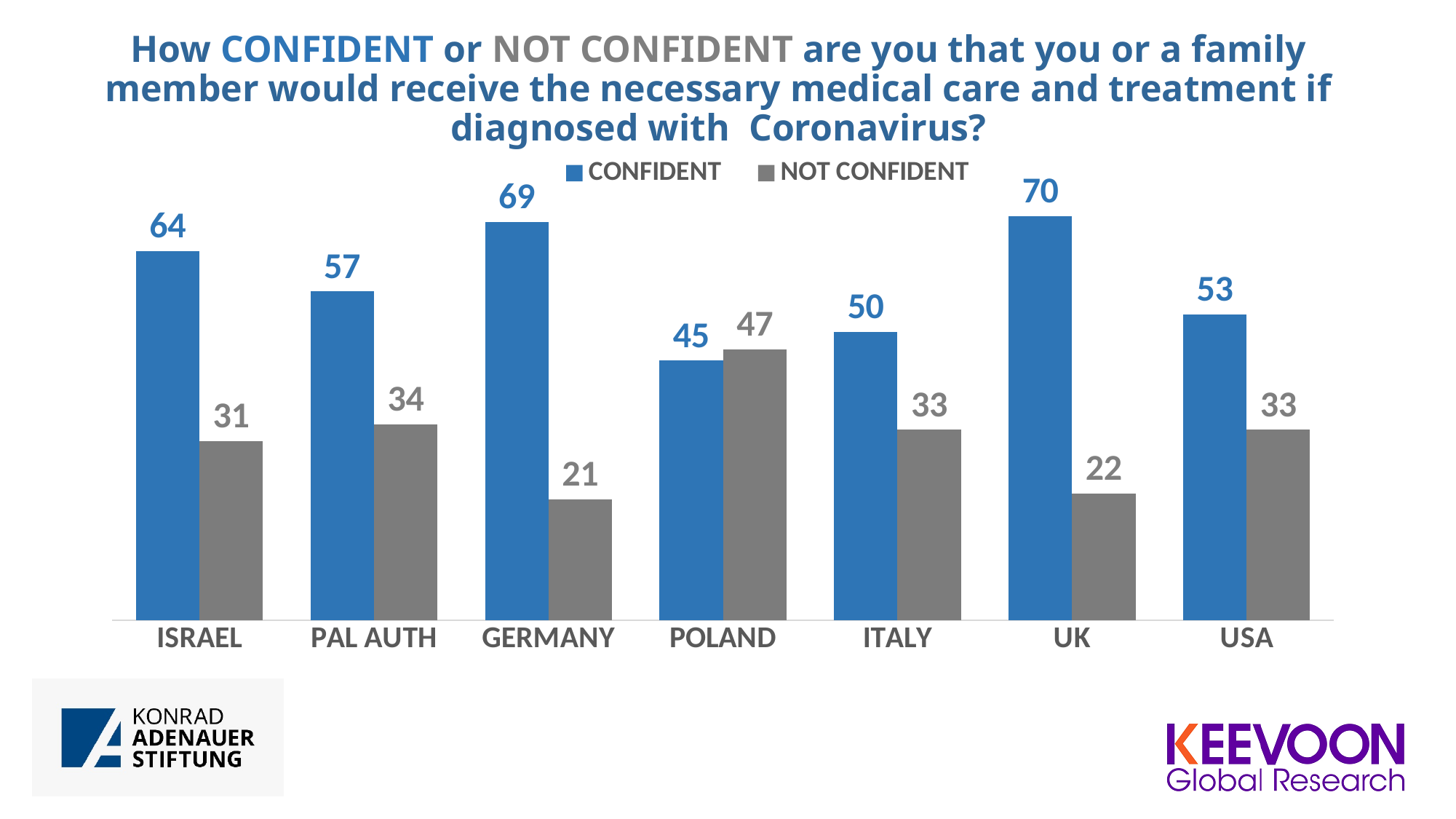
What is the CONFIDENT value for Germany? 69 Which country has the lowest NOT CONFIDENT value? Germany Which is larger for Poland, the CONFIDENT value or the NOT CONFIDENT value? NOT CONFIDENT Which country has the lowest CONFIDENT value? Poland How many countries are shown on the x axis? 7 How many series does the legend list? 2 Which colour represents the NOT CONFIDENT series? Grey Which country has the highest CONFIDENT value? UK What is the difference between the CONFIDENT and NOT CONFIDENT values for Israel? 33 What is the CONFIDENT value for the USA? 53 What is the NOT CONFIDENT value for Poland? 47 What kind of chart is shown on the slide? Bar chart